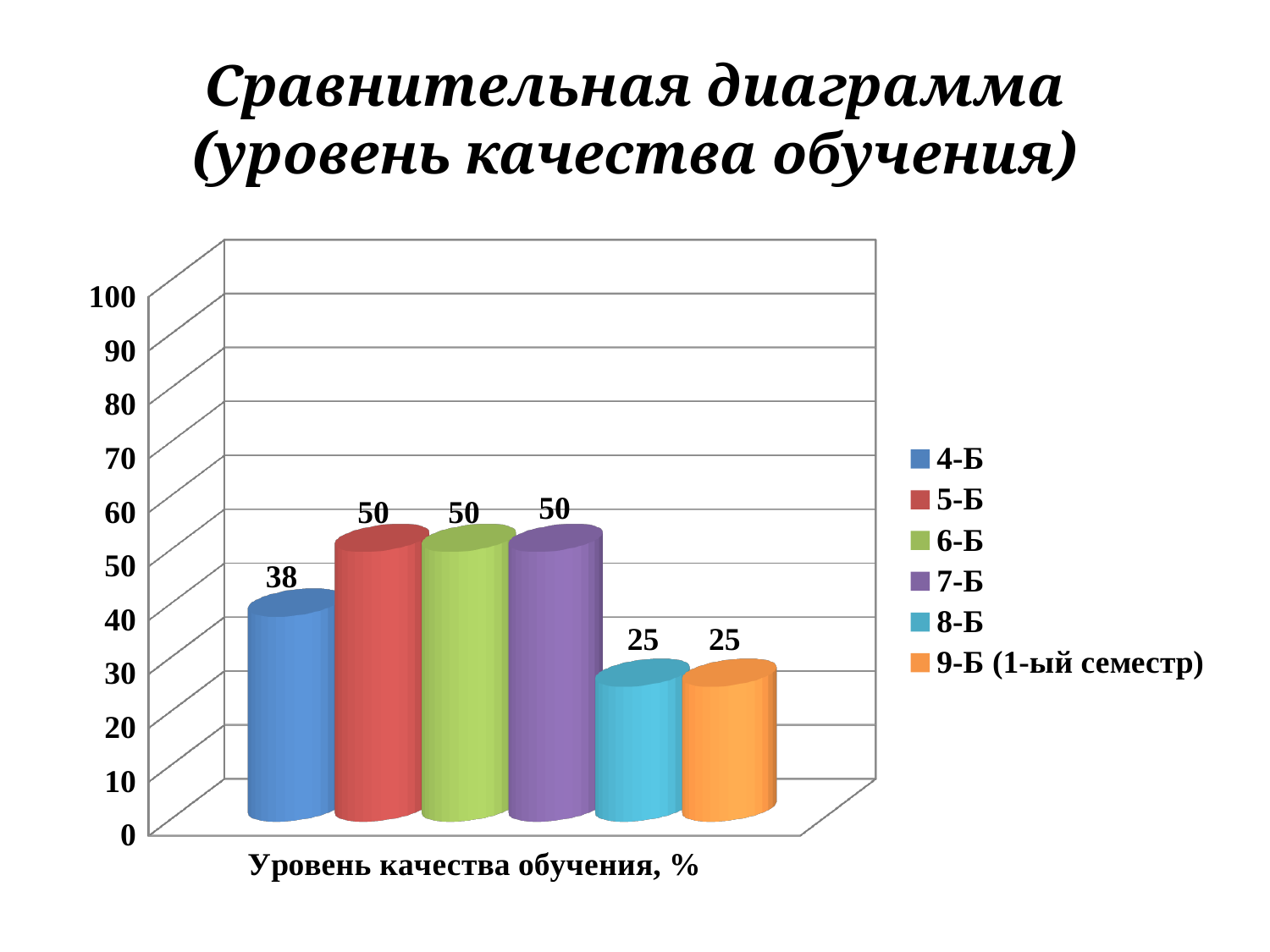
What is the label on the horizontal axis of the chart? Уровень качества обучения, % What is the value for 6-Б? 50 How many series does the legend list? 6 What is the value for 4-Б? 38 What is the difference between the values for 5-Б and 4-Б? 12 What is the difference between the values for 4-Б and 9-Б (1-ый семестр)? 13 What kind of chart is shown on the slide? bar chart Which is larger, the value for 7-Б or the value for 4-Б? 7-Б Is the value for 4-Б greater or less than 40? less What is the value for 9-Б (1-ый семестр)? 25 Which series has the lowest value, 4-Б or 8-Б? 8-Б What is the value for 8-Б? 25